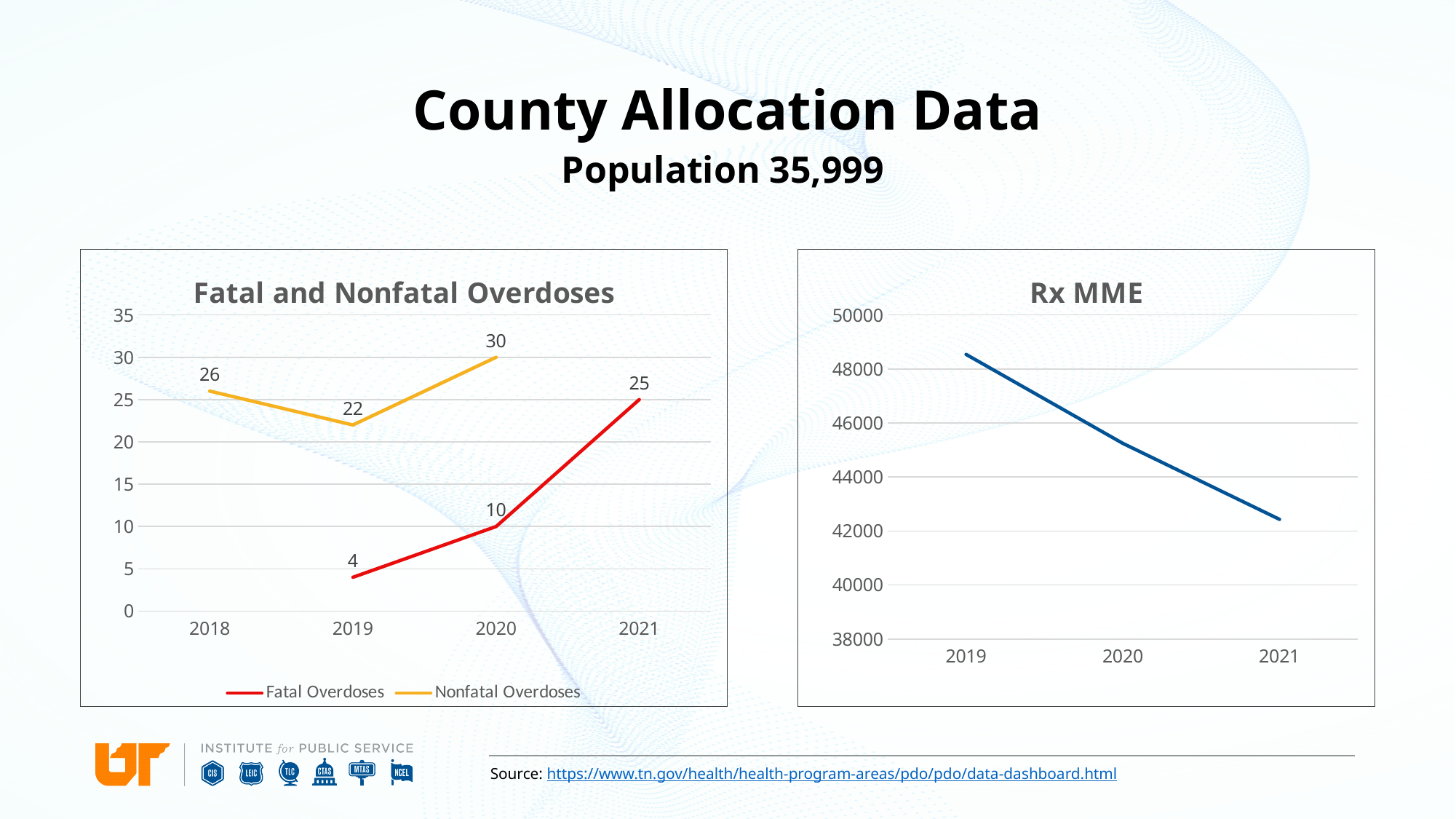
In the Fatal and Nonfatal Overdoses chart, what is the value for Nonfatal Overdoses in 2019? 22 In the Fatal and Nonfatal Overdoses chart, do the Fatal Overdoses values rise or fall from 2019 to 2021? Rise How many years are shown on the x axis of the Rx MME chart? 3 In the Fatal and Nonfatal Overdoses chart, which series has the larger value in 2020, Fatal Overdoses or Nonfatal Overdoses? Nonfatal Overdoses In the Rx MME chart, do the values rise or fall from 2019 to 2021? Fall In the Fatal and Nonfatal Overdoses chart, what is the value for Fatal Overdoses in 2021? 25 How many series does the legend of the Fatal and Nonfatal Overdoses chart list? 2 What kind of chart is the Fatal and Nonfatal Overdoses chart? Line chart In the Fatal and Nonfatal Overdoses chart, in which year is Nonfatal Overdoses highest? 2020 In the Fatal and Nonfatal Overdoses chart, in which year is Fatal Overdoses lowest? 2019 In the Fatal and Nonfatal Overdoses chart, what is the difference between Nonfatal Overdoses in 2020 and in 2019? 8 In the Rx MME chart, is the value for 2019 greater or less than 48000? greater